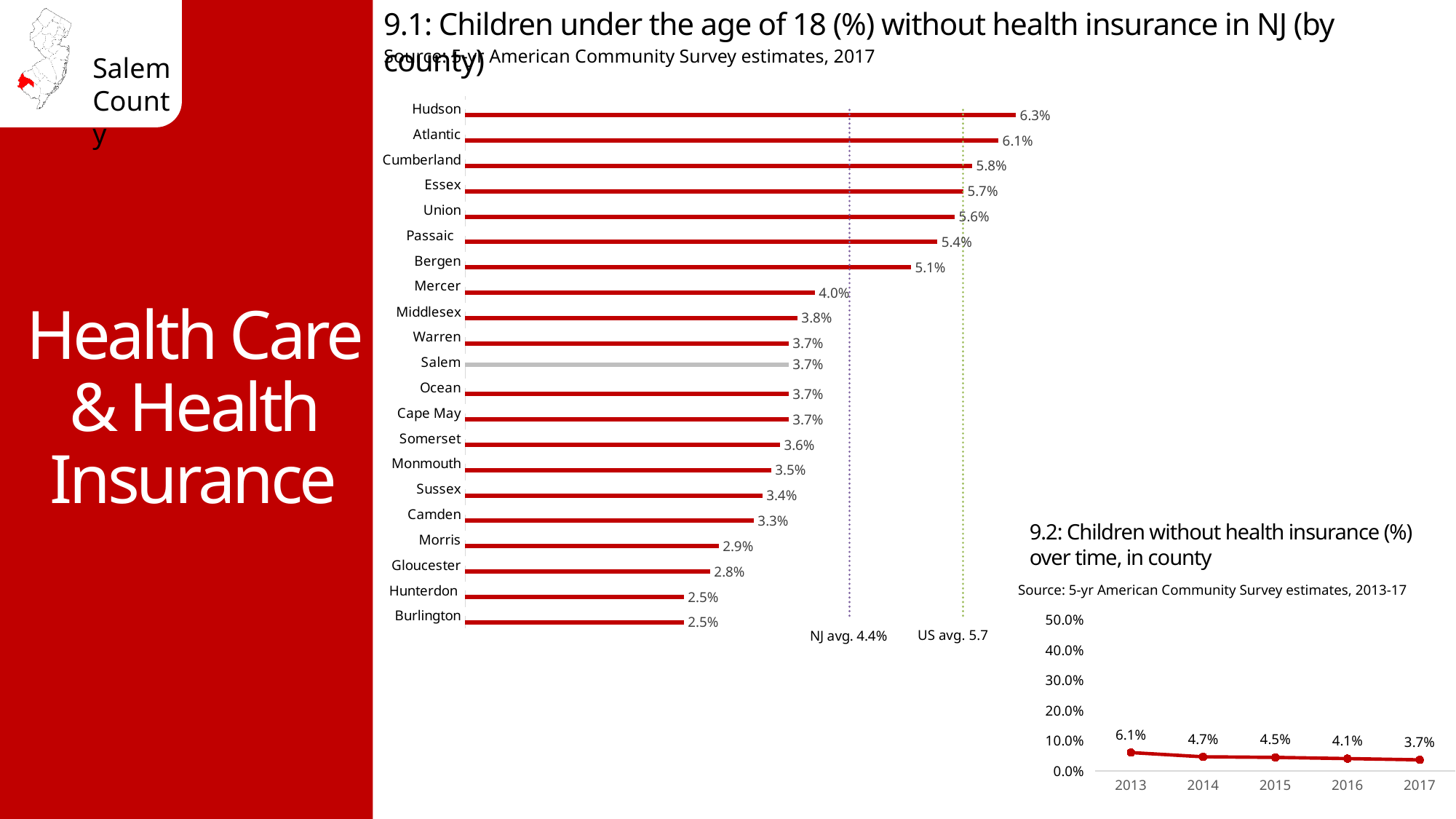
In chart 9.1, which is larger, the value for Bergen or the value for Mercer? Bergen In chart 9.2, what is the value for 2013? 6.1% What kind of chart is chart 9.1? Bar chart In chart 9.1, how many counties are shown? 21 In chart 9.1, what is the value for Salem? 3.7% In chart 9.1, what is the value for Hudson? 6.3% In chart 9.2, what is the value for 2017? 3.7% In chart 9.1, what NJ average is marked by the dotted line? 4.4% In chart 9.2, what is the difference between the 2013 and 2017 values? 2.4% In chart 9.2, do the values rise or fall from 2013 to 2017? Fall In chart 9.1, which county has the highest percentage of children without health insurance? Hudson In chart 9.1, what is the difference between Hudson and Burlington? 3.8%